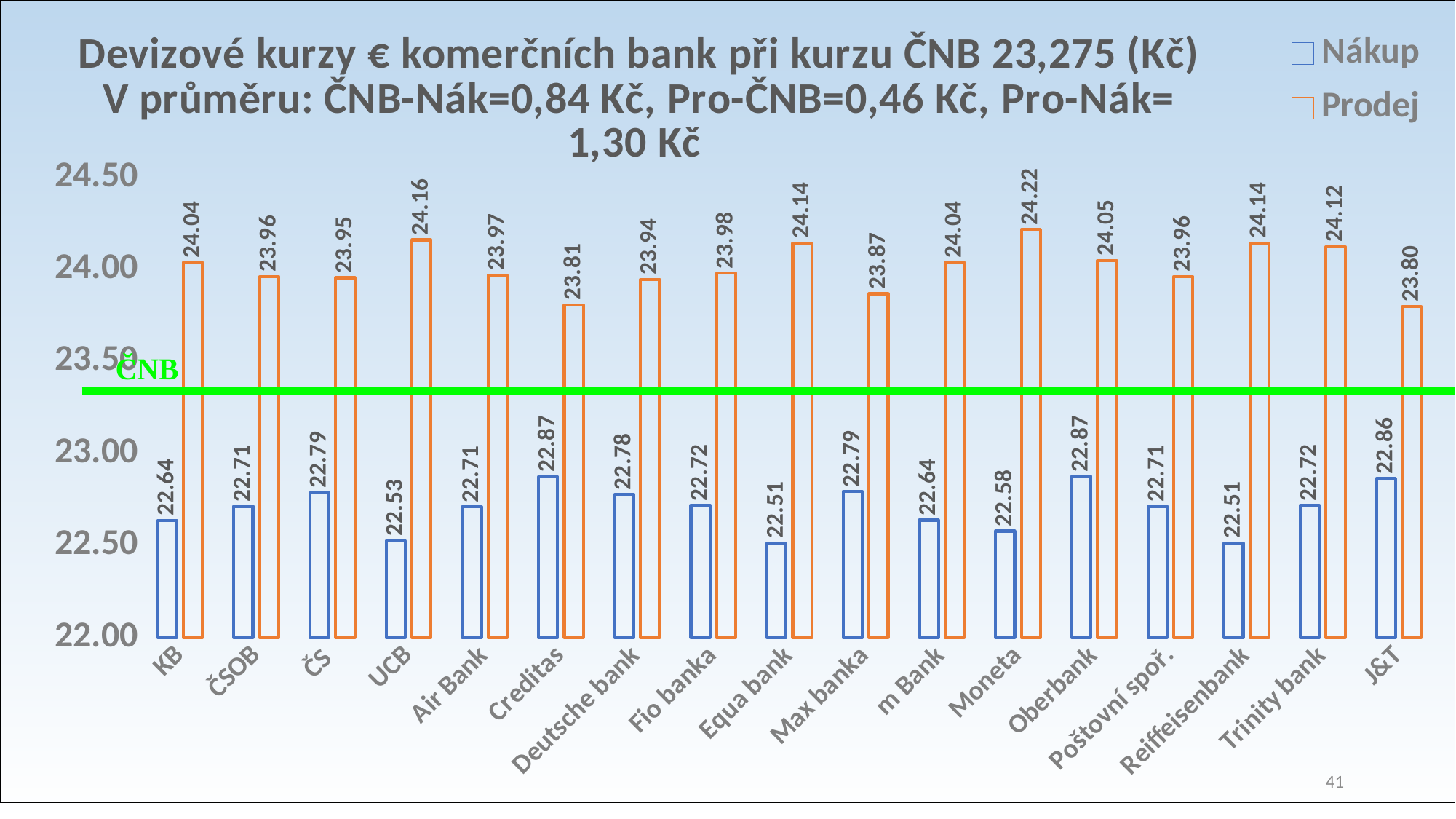
Which bank has the highest Prodej value? Moneta What is the Nákup value for Equa bank? 22.51 What is the Prodej value for Moneta? 24.22 What is the difference between the Prodej and Nákup values for UCB? 1.63 What is the Prodej value for UCB? 24.16 What label is attached to the green horizontal line on the chart? ČNB What kind of chart is shown on the slide? bar chart Which bank has the lowest Prodej value? J&T Is the Prodej value for Creditas greater or less than 24.00? less How many banks are shown on the x axis? 17 How many series does the legend list? 2 Which is larger, the Nákup value for KB or the Nákup value for ČS? ČS